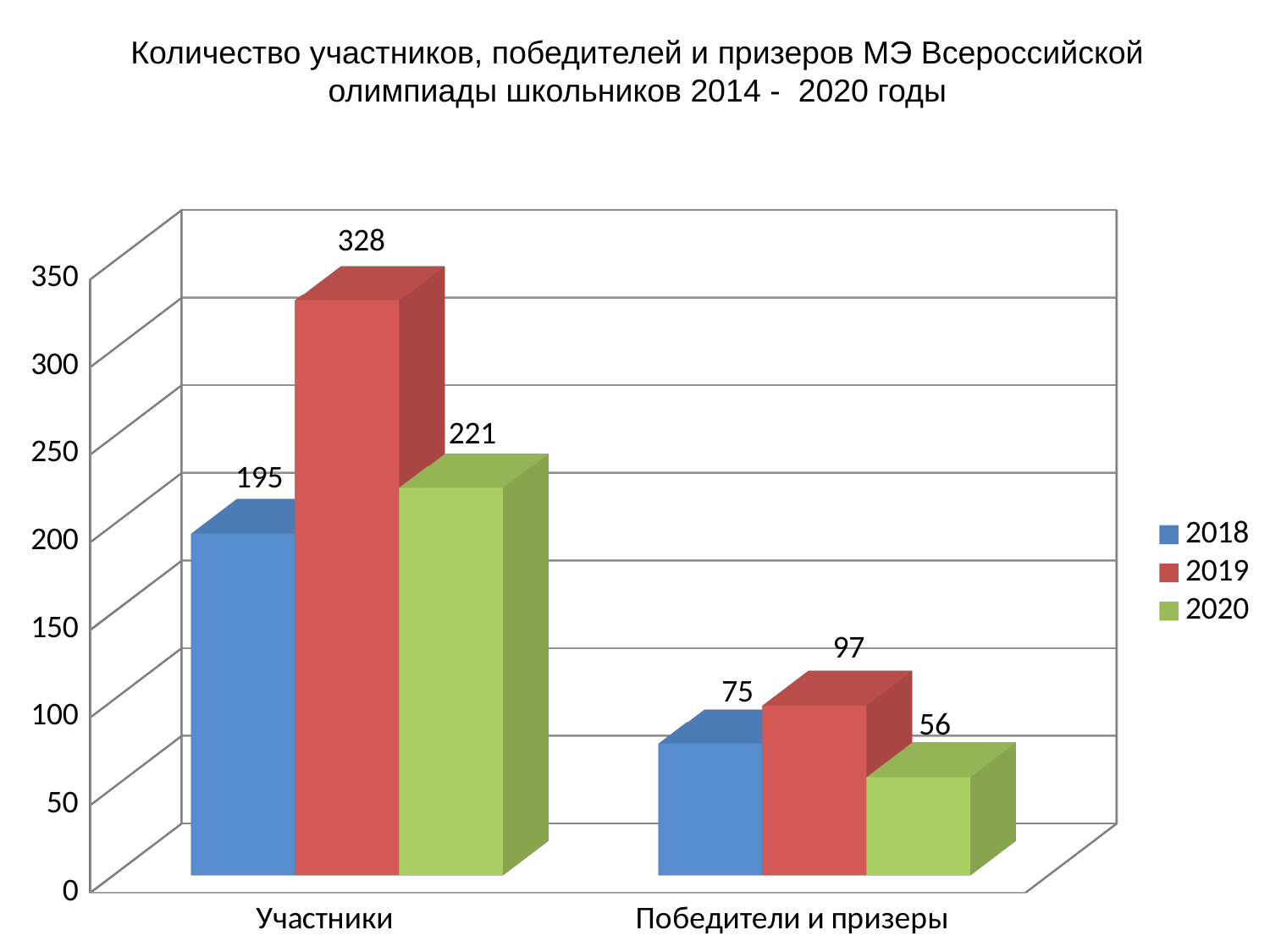
What is the value for 2020 in the Победители и призеры category? 56 What is the difference between the 2018 and 2020 values in the Победители и призеры category? 19 Which colour represents the 2019 series in the legend? red How many series does the legend list? 3 What is the difference between the 2019 and 2018 values in the Участники category? 133 How many categories are shown on the x axis? 2 Which year has the highest value in the Участники category? 2019 What is the value for 2019 in the Участники category? 328 Which is larger: the 2020 value for Участники or the 2018 value for Участники? 2020 Which year has the lowest value in the Победители и призеры category? 2020 What kind of chart is shown on the slide? bar chart What is the value for 2018 in the Участники category? 195